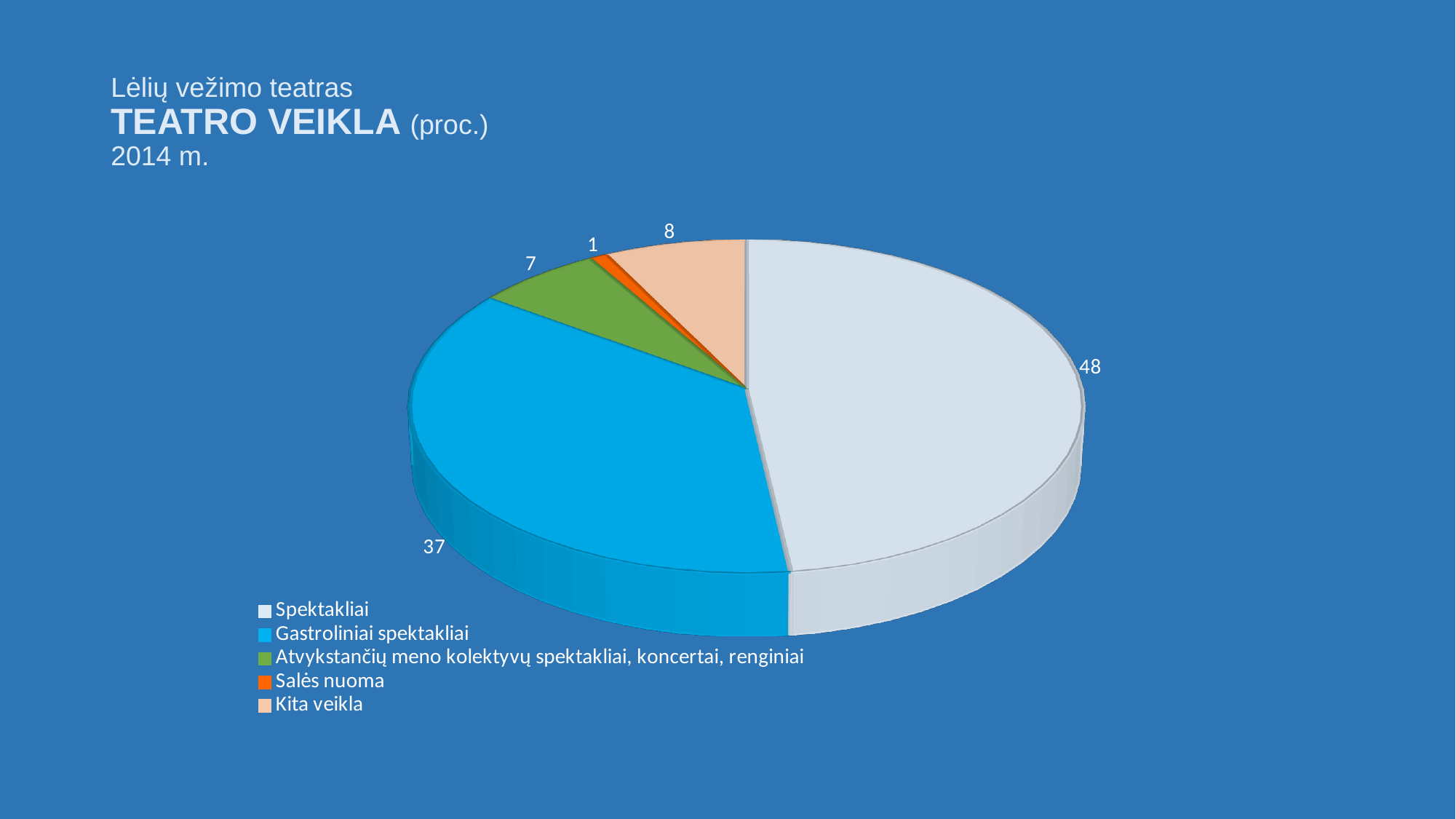
Which category has the smallest slice of the pie? Salės nuoma What is the value for Atvykstančių meno kolektyvų spektakliai, koncertai, renginiai? 7 What is the difference between the values for Spektakliai and Gastroliniai spektakliai? 11 What is the value for Kita veikla? 8 What year is shown in the chart title? 2014 m. What type of chart is shown on the slide? pie chart What is the value for Salės nuoma? 1 What is the value for Gastroliniai spektakliai? 37 Which is larger, the value for Kita veikla or the value for Atvykstančių meno kolektyvų spektakliai, koncertai, renginiai? Kita veikla How many categories does the pie chart show? 5 What is the value for Spektakliai? 48 Which category has the largest slice of the pie? Spektakliai